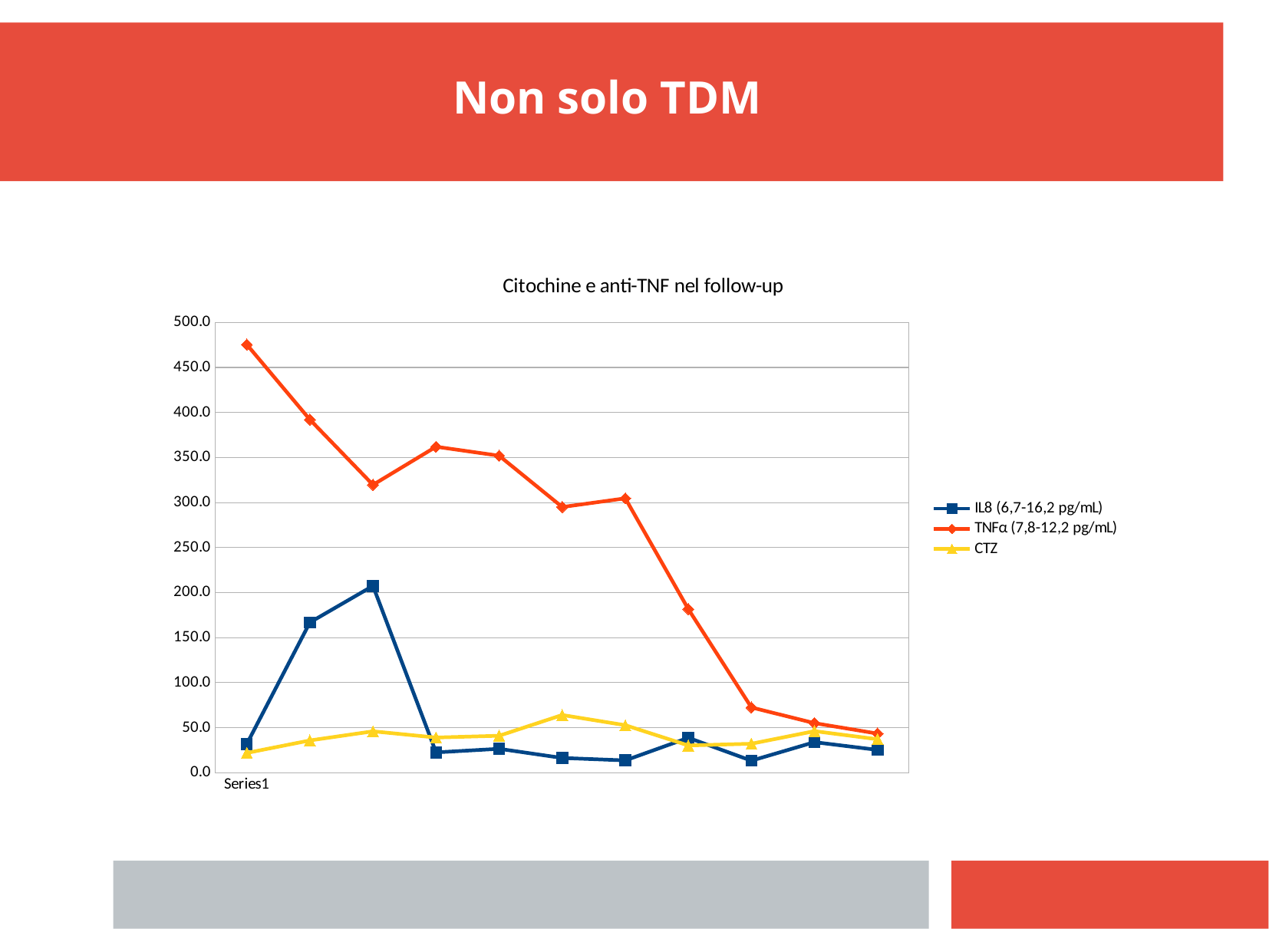
At the first point on the x axis, which is larger: the TNFα (7,8-12,2 pg/mL) value or the IL8 (6,7-16,2 pg/mL) value? TNFα (7,8-12,2 pg/mL) Which series is shown with a yellow line and triangle markers? CTZ Is the highest value of the CTZ series greater or less than 100? less Is the last value of the TNFα (7,8-12,2 pg/mL) series greater or less than 50? less Is the first value of the TNFα (7,8-12,2 pg/mL) series greater or less than 450? greater How many data points does the TNFα (7,8-12,2 pg/mL) series have? 11 What is the title of the chart? Citochine e anti-TNF nel follow-up How many series does the legend of the chart list? 3 Does the TNFα (7,8-12,2 pg/mL) series generally rise or fall from left to right? fall What kind of chart is shown on the slide? line chart Which series has the highest value at the first point on the x axis? TNFα (7,8-12,2 pg/mL)